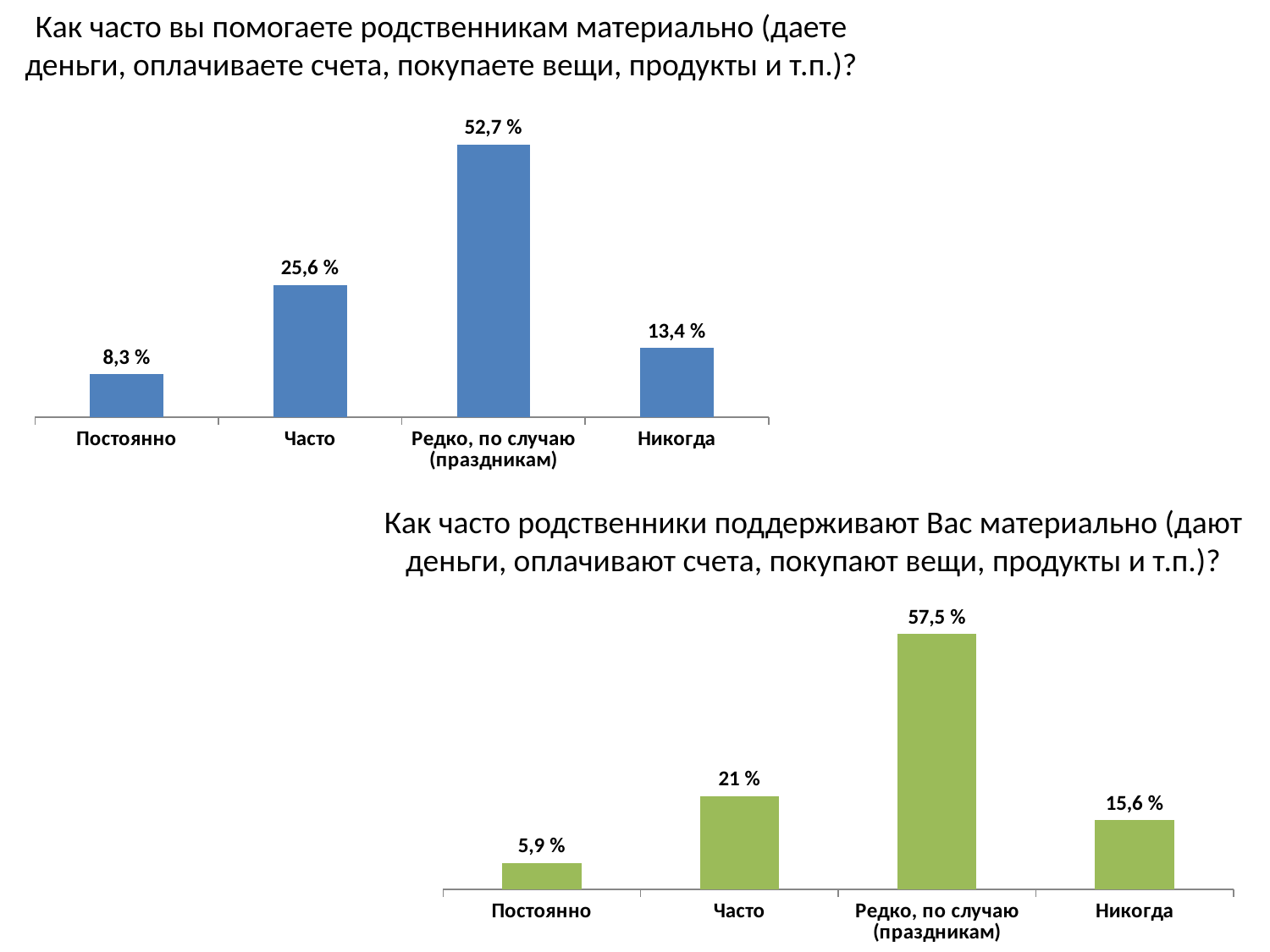
How many categories are shown in the bottom chart? 4 In the bottom chart, what is the difference between «Часто» and «Никогда»? 5,4 % In the top chart, which category has the highest value? Редко, по случаю (праздникам) In the bottom chart, which is larger: «Часто» or «Никогда»? Часто In the bottom chart, what is the value for «Постоянно»? 5,9 % In the top chart, what is the value for «Никогда»? 13,4 % In the top chart, what is the value for «Часто»? 25,6 % In the bottom chart, which category has the lowest value? Постоянно In the top chart, which category has the lowest value? Постоянно What type of chart is the top chart? Bar chart In the bottom chart, what is the value for «Редко, по случаю (праздникам)»? 57,5 % In the top chart, what is the difference between «Редко, по случаю (праздникам)» and «Часто»? 27,1 %